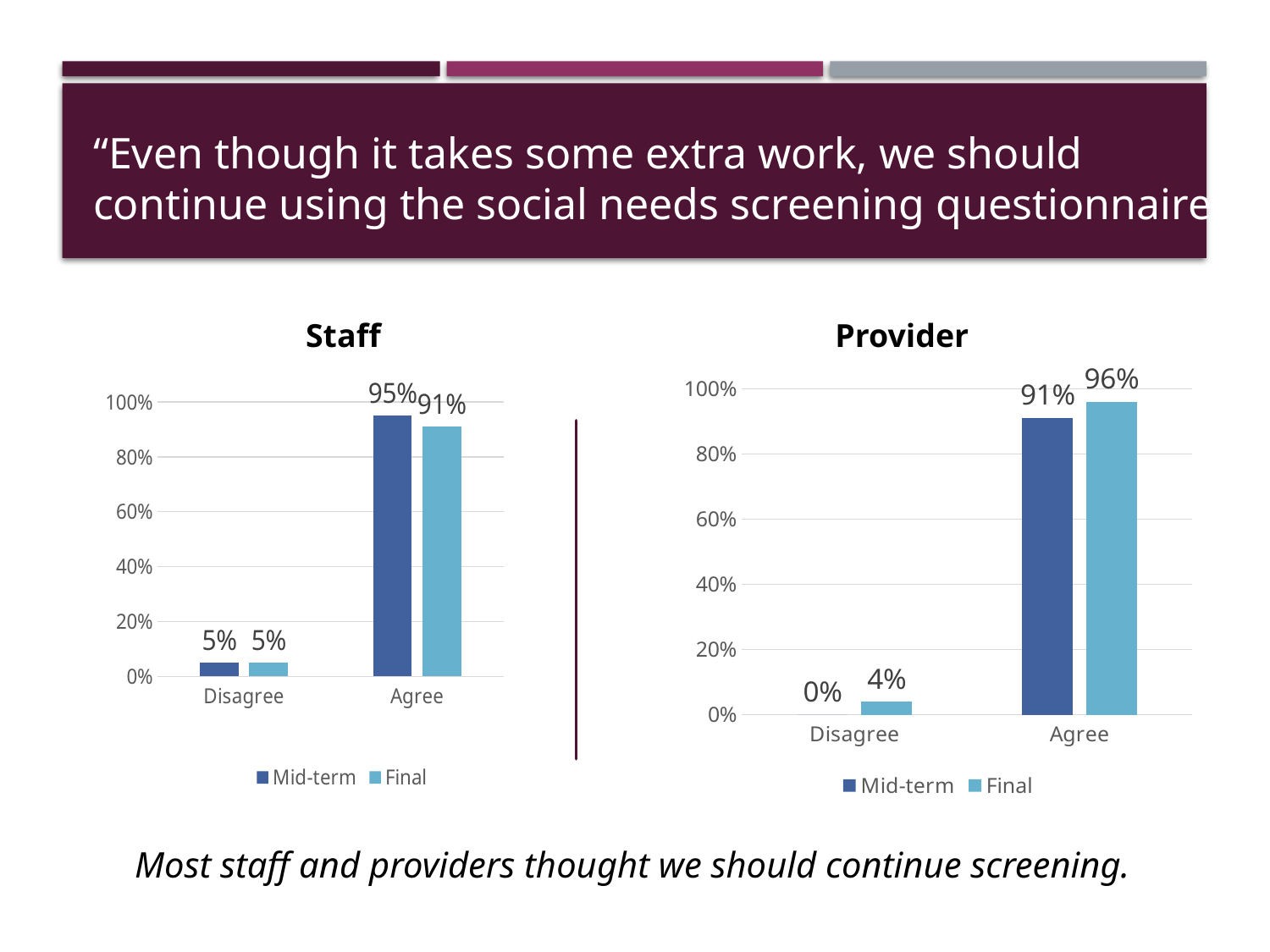
In the Staff chart, what is the difference between the Mid-term and Final values for Agree? 4% In the Provider chart, what is the difference between the Final and Mid-term values for Agree? 5% In the Provider chart, what is the Mid-term value for Disagree? 0% In the Staff chart, what is the Final value for Disagree? 5% In the Provider chart, what is the Final value for Disagree? 4% In the Staff chart, what is the Mid-term value for Agree? 95% In the Provider chart, what is the Final value for Agree? 96% In the Staff chart, which is larger for Agree: Mid-term or Final? Mid-term How many series does the legend of the Provider chart list? 2 What kind of chart is the Staff chart? Bar chart How many categories are shown on the x axis of the Staff chart? 2 In the Provider chart, which is larger for Agree: Mid-term or Final? Final